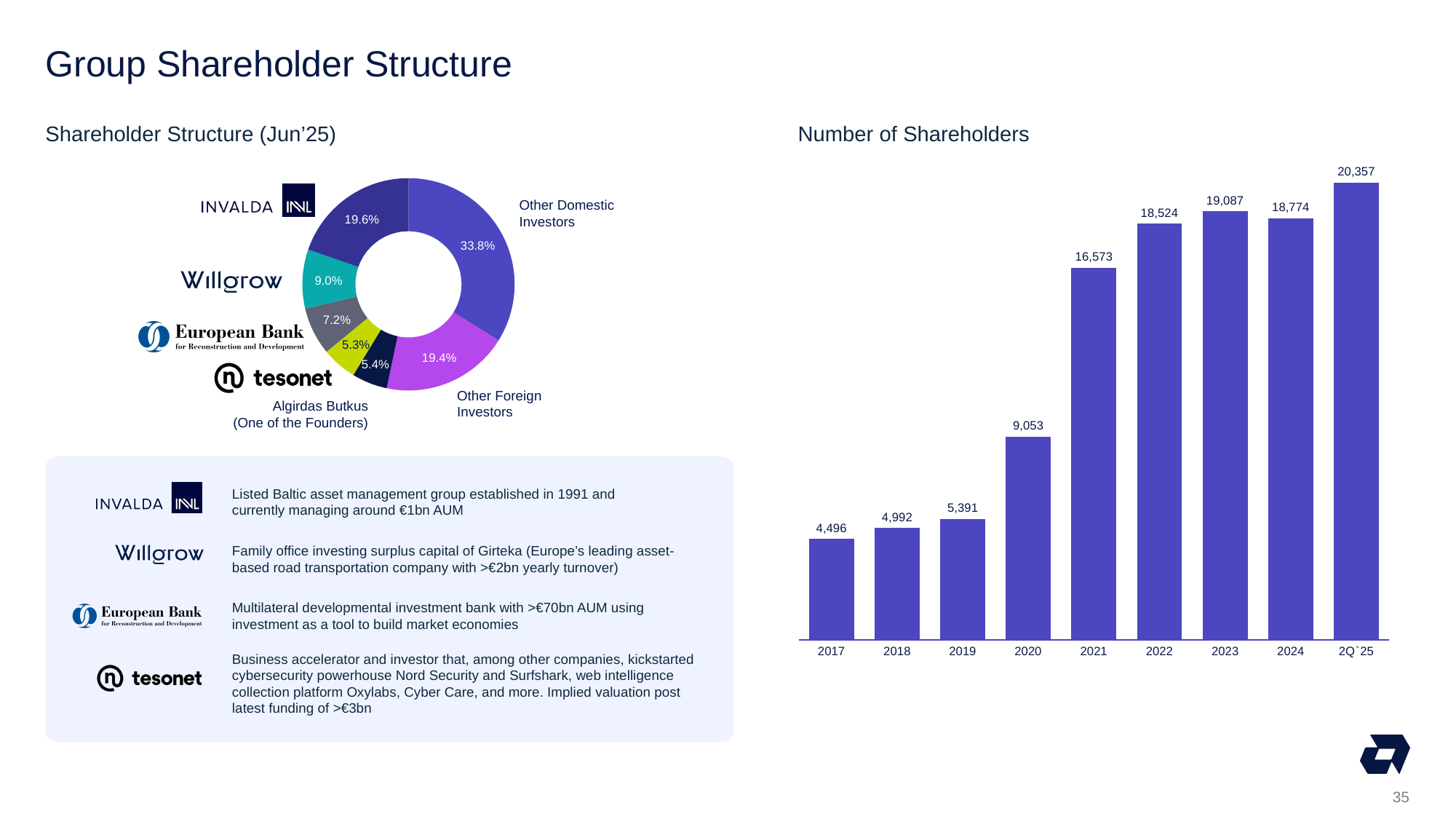
What type of chart is the Shareholder Structure (Jun'25) chart? Pie (donut) chart In the Number of Shareholders chart, what is the difference between the 2020 and 2019 values? 3,662 What type of chart is the Number of Shareholders chart? Bar chart In the Shareholder Structure (Jun'25) chart, what share is held by Willgrow? 9.0% In the Shareholder Structure (Jun'25) chart, what share is held by Other Domestic Investors? 33.8% In the Number of Shareholders chart, what is the value for 2021? 16,573 In the Shareholder Structure (Jun'25) chart, which shareholder group has the largest share? Other Domestic Investors In the Number of Shareholders chart, which period has the highest number of shareholders? 2Q`25 In the Number of Shareholders chart, which is larger, the value for 2023 or the value for 2024? 2023 In the Number of Shareholders chart, what is the value for 2Q`25? 20,357 How many bars are shown in the Number of Shareholders chart? 9 In the Number of Shareholders chart, which year has the lowest number of shareholders? 2017